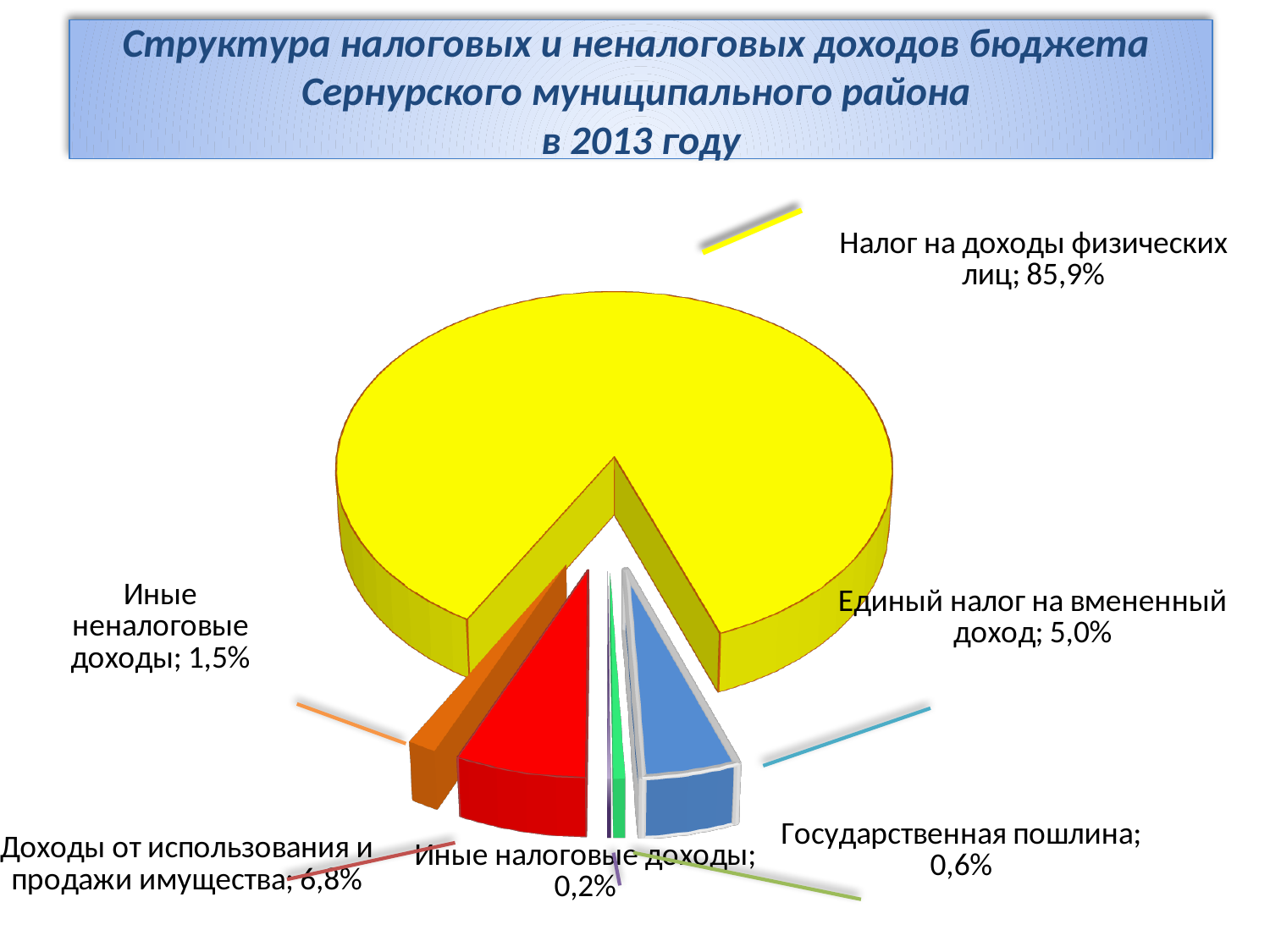
What share of the pie is labelled for Налог на доходы физических лиц? 85,9% What is the value shown for Иные неналоговые доходы? 1,5% What is the value shown for Доходы от использования и продажи имущества? 6,8% How many slices does the pie chart have? 6 Which category has the largest share of the pie? Налог на доходы физических лиц Which category has the smallest share of the pie? Иные налоговые доходы What is the difference in percentage points between Доходы от использования и продажи имущества and Иные неналоговые доходы? 5,3% What colour is the slice for Налог на доходы физических лиц? Yellow What is the value shown for Единый налог на вмененный доход? 5,0% What is the value shown for Государственная пошлина? 0,6% What kind of chart is shown on the slide? Pie chart Which is larger: Единый налог на вмененный доход or Доходы от использования и продажи имущества? Доходы от использования и продажи имущества